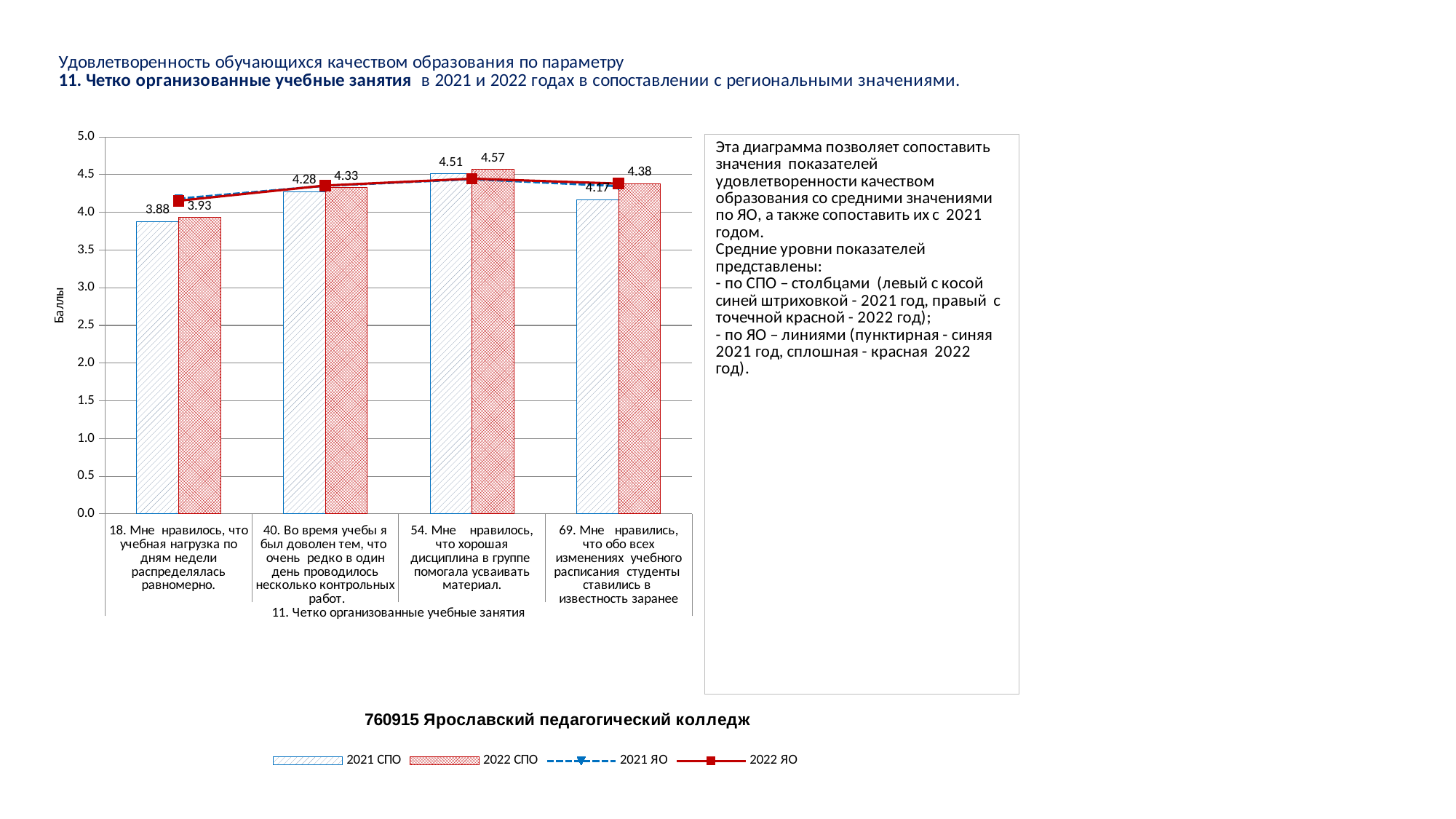
What is the difference between the 2022 СПО and 2021 СПО values for category 40? 0.05 What is the difference between the 2022 СПО and 2021 СПО values for category 69? 0.21 Is the 2022 ЯО line value for category 18 greater or less than 3.5? greater What is the value of the 2022 СПО bar for category 54 ("Мне нравилось, что хорошая дисциплина в группе помогала усваивать материал")? 4.57 How many series does the legend list? 4 What is the label of the y axis? Баллы Which category has the highest 2022 СПО value? 54. Мне нравилось, что хорошая дисциплина в группе помогала усваивать материал. Which is larger for category 18: the 2021 СПО value or the 2022 СПО value? 2022 СПО What is the value of the 2021 СПО bar for category 69 ("Мне нравились, что обо всех изменениях учебного расписания студенты ставились в известность заранее")? 4.17 How many categories are shown on the x axis? 4 Which category has the lowest 2021 СПО value? 18. Мне нравилось, что учебная нагрузка по дням недели распределялась равномерно. What is the value of the 2021 СПО bar for category 18 ("Мне нравилось, что учебная нагрузка по дням недели распределялась равномерно")? 3.88